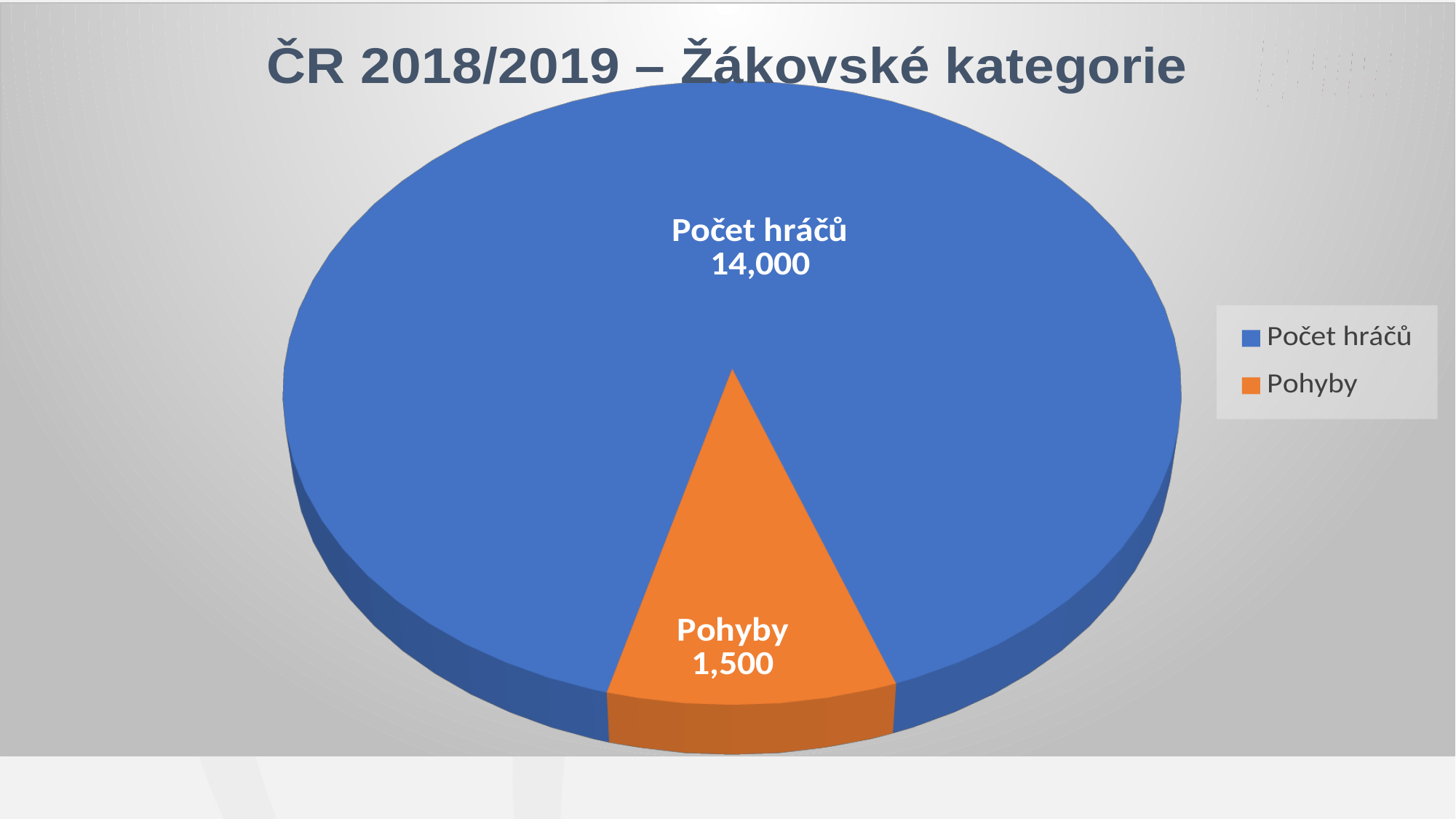
How many slices does the pie chart have? 2 Which slice is the smallest? Pohyby What is the title of the chart? ČR 2018/2019 – Žákovské kategorie Which is larger, Počet hráčů or Pohyby? Počet hráčů What colour is the Pohyby slice? Orange Which slice is the largest? Počet hráčů What is the total of the two slices? 15,500 What is the difference between Počet hráčů and Pohyby? 12,500 How many entries does the legend list? 2 What is the value for Pohyby? 1,500 What kind of chart is shown on the slide? Pie chart What is the value for Počet hráčů? 14,000